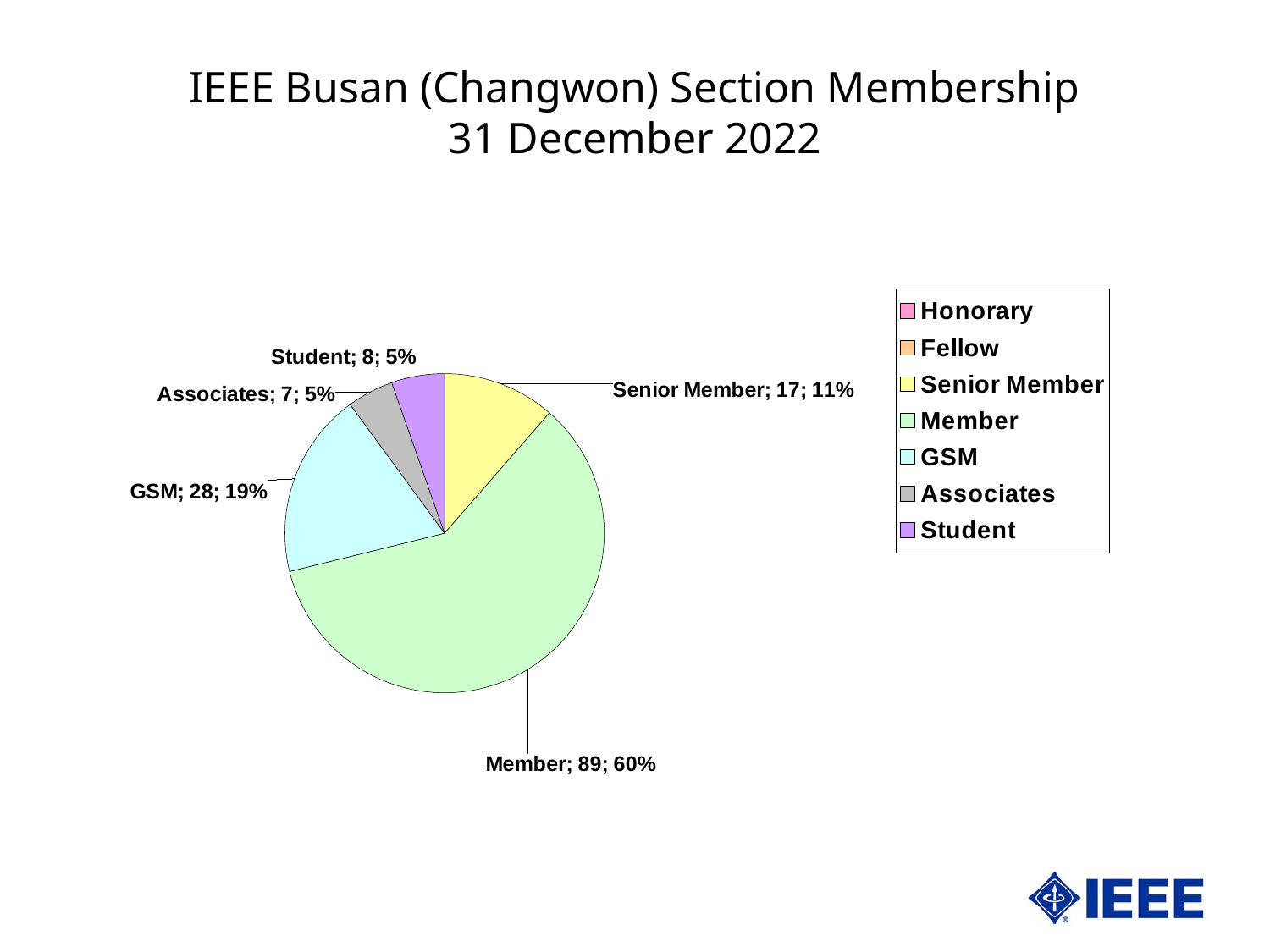
What percentage of the pie does Member account for? 60% Which labelled slice is the smallest? Associates What is the difference between the Member count and the GSM count? 61 What share of the pie does GSM represent? 19% What kind of chart is shown on the slide? Pie chart Which is larger, the Student count or the Associates count? Student How many members are in the Member category? 89 What is the title of the slide? IEEE Busan (Changwon) Section Membership 31 December 2022 Which category has the largest slice of the pie? Member What is the value for Senior Member? 17 What colour is the Member slice? Light green How many entries does the legend list? 7